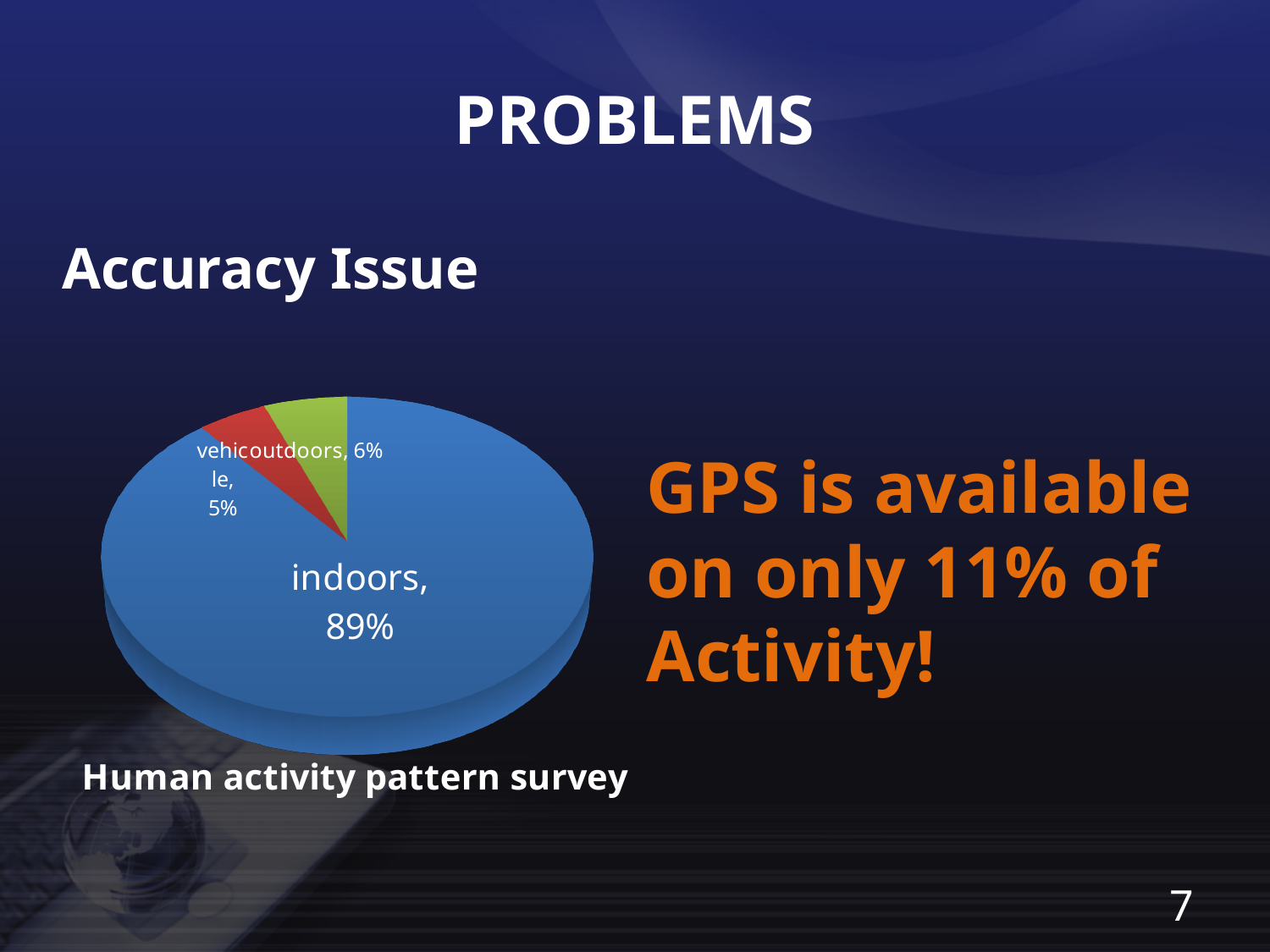
What share of the pie does the vehicle slice represent? 5% Which category has the smallest slice of the pie? vehicle Which category has the largest slice of the pie? indoors What is the difference in percentage points between the indoors and outdoors slices? 83 What colour is the indoors slice of the pie? blue What share of the pie does the indoors slice represent? 89% How many slices does the pie chart have? 3 What is the combined share of the outdoors and vehicle slices? 11% What is the difference in percentage points between the outdoors and vehicle slices? 1 Which is larger, the indoors slice or the vehicle slice? indoors What share of the pie does the outdoors slice represent? 6% What kind of chart is shown on the slide? pie chart